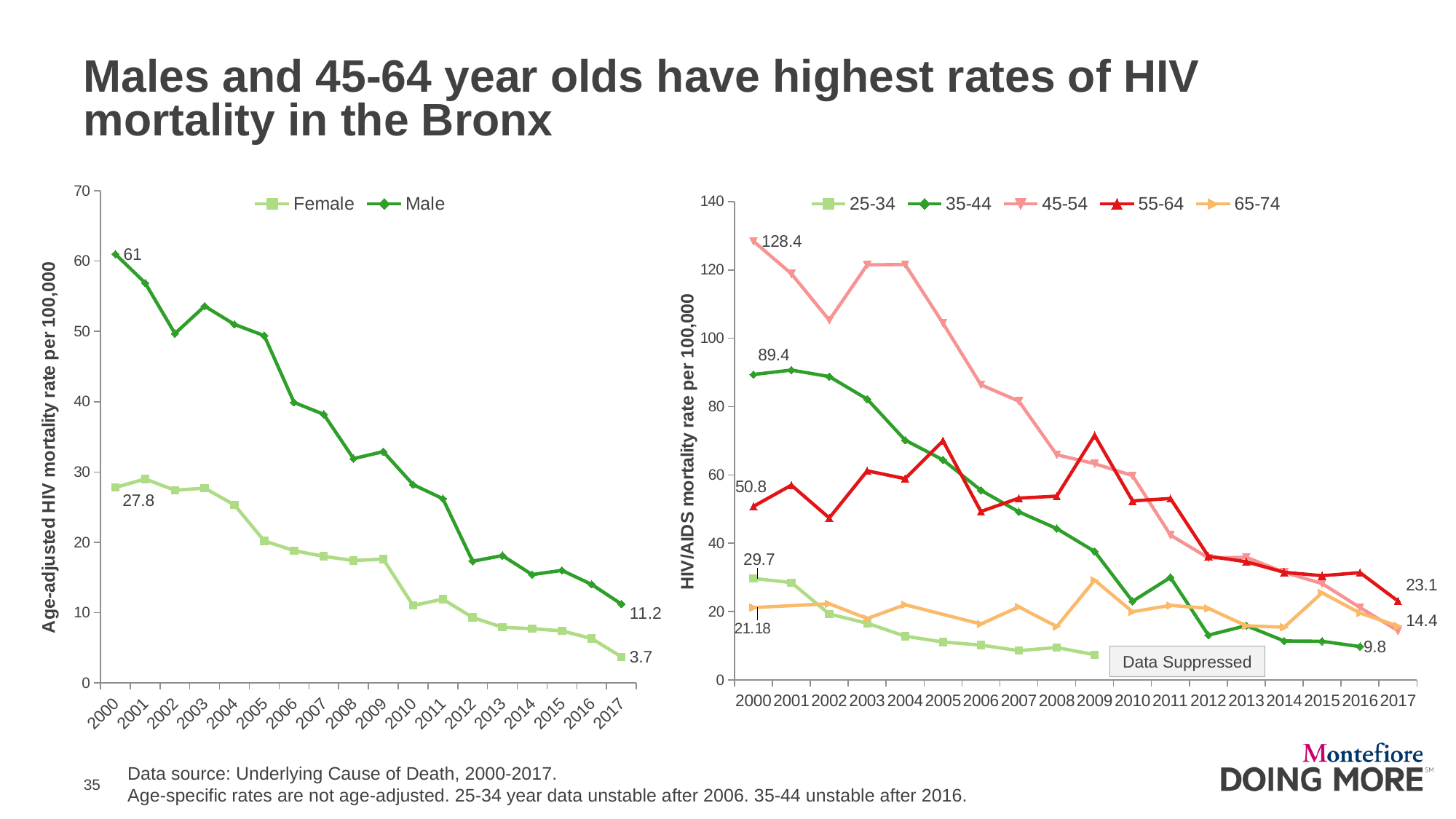
On the left chart, what is the age-adjusted HIV mortality rate for Male in 2000? 61 On the left chart, what is the Male rate in 2017? 11.2 On the left chart, what is the difference between the Male and Female rates in 2000? 33.2 How many series does the legend of the left chart list? 2 What kind of chart is the left chart showing Female and Male rates? line chart On the right chart, which age group has the highest rate in 2000? 45-54 How many series does the legend of the right chart list? 5 On the right chart, what is the HIV/AIDS mortality rate for the 45-54 age group in 2000? 128.4 On the right chart, what is the rate for the 35-44 age group in 2016? 9.8 On the right chart, is the value for the 55-64 age group in 2009 greater or less than 60? greater On the left chart, what is the age-adjusted HIV mortality rate for Female in 2017? 3.7 On the left chart, do the Male rates rise or fall from 2000 to 2017? fall